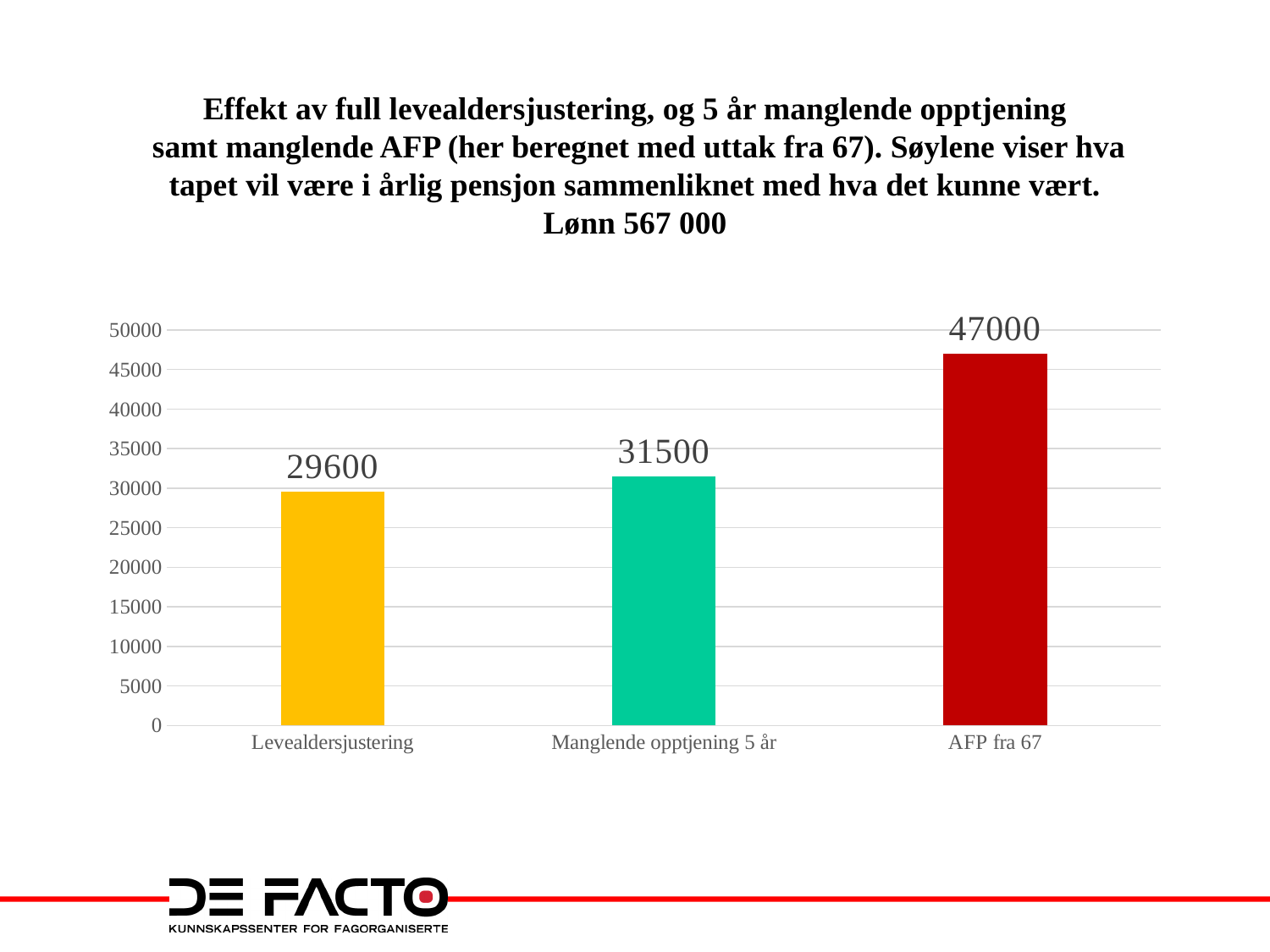
What is the difference between the values for AFP fra 67 and Levealdersjustering? 17400 What is the difference between the values for Manglende opptjening 5 år and Levealdersjustering? 1900 What kind of chart is shown on the slide? bar chart How many categories are shown on the x axis? 3 Which is larger, the value for Manglende opptjening 5 år or the value for Levealdersjustering? Manglende opptjening 5 år What is the value for AFP fra 67? 47000 What colour is the bar for AFP fra 67? red Is the value for AFP fra 67 greater or less than 45000? greater What is the value for Manglende opptjening 5 år? 31500 Which category has the highest value? AFP fra 67 Which category has the lowest value? Levealdersjustering What is the value for Levealdersjustering? 29600